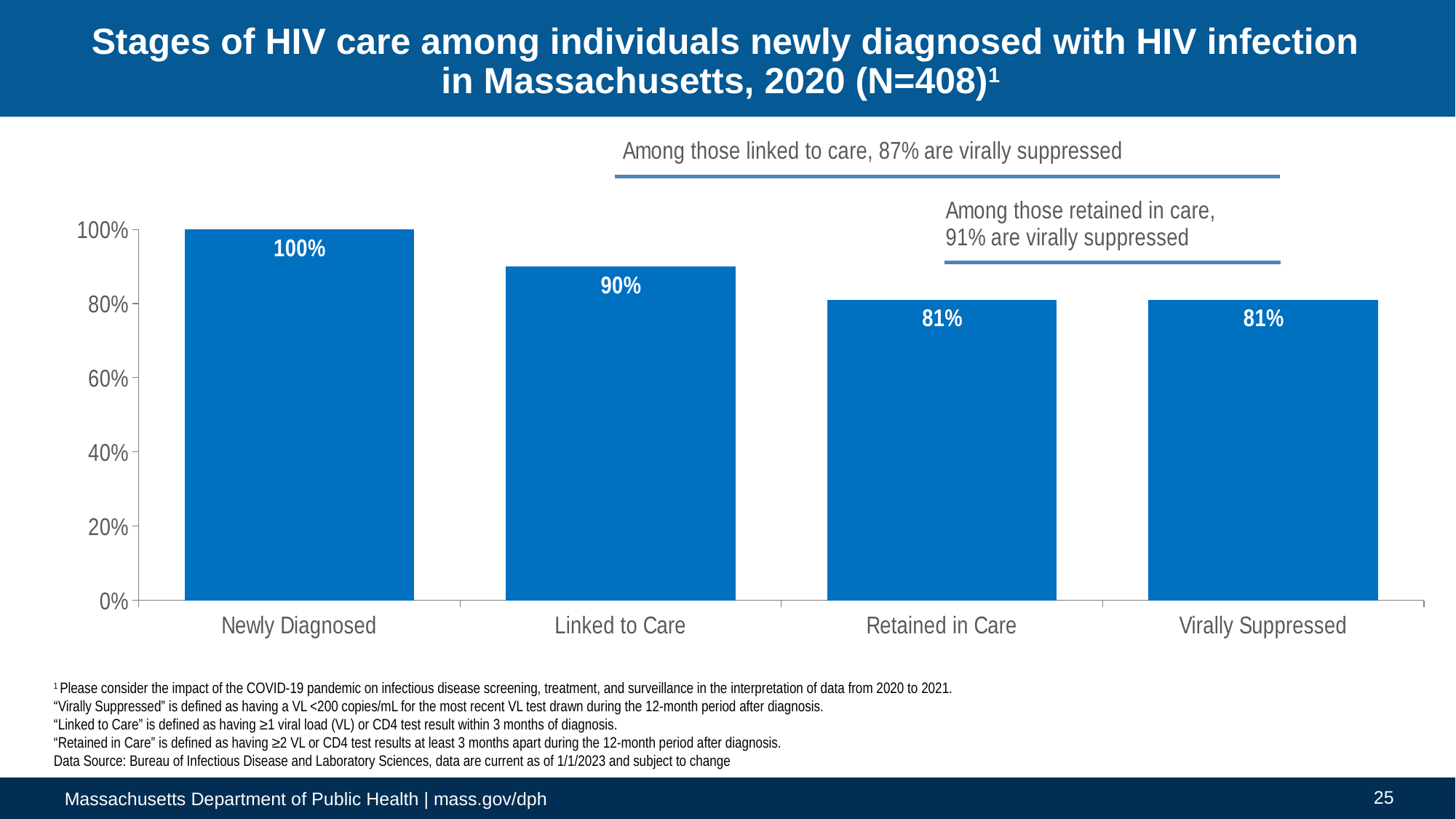
Which category has the highest value? Newly Diagnosed What is the value for Newly Diagnosed? 100% What is the difference between the values for Linked to Care and Retained in Care? 9% Which is larger, the value for Linked to Care or the value for Virally Suppressed? Linked to Care Do the values rise or fall from Newly Diagnosed to Retained in Care? Fall How many categories are shown on the x axis? 4 What is the value for Virally Suppressed? 81% What kind of chart is shown on the slide? Bar chart What is the value for Retained in Care? 81% What is the value for Linked to Care? 90% According to the annotation on the chart, what percentage of those linked to care are virally suppressed? 87% What is the difference between the values for Newly Diagnosed and Linked to Care? 10%